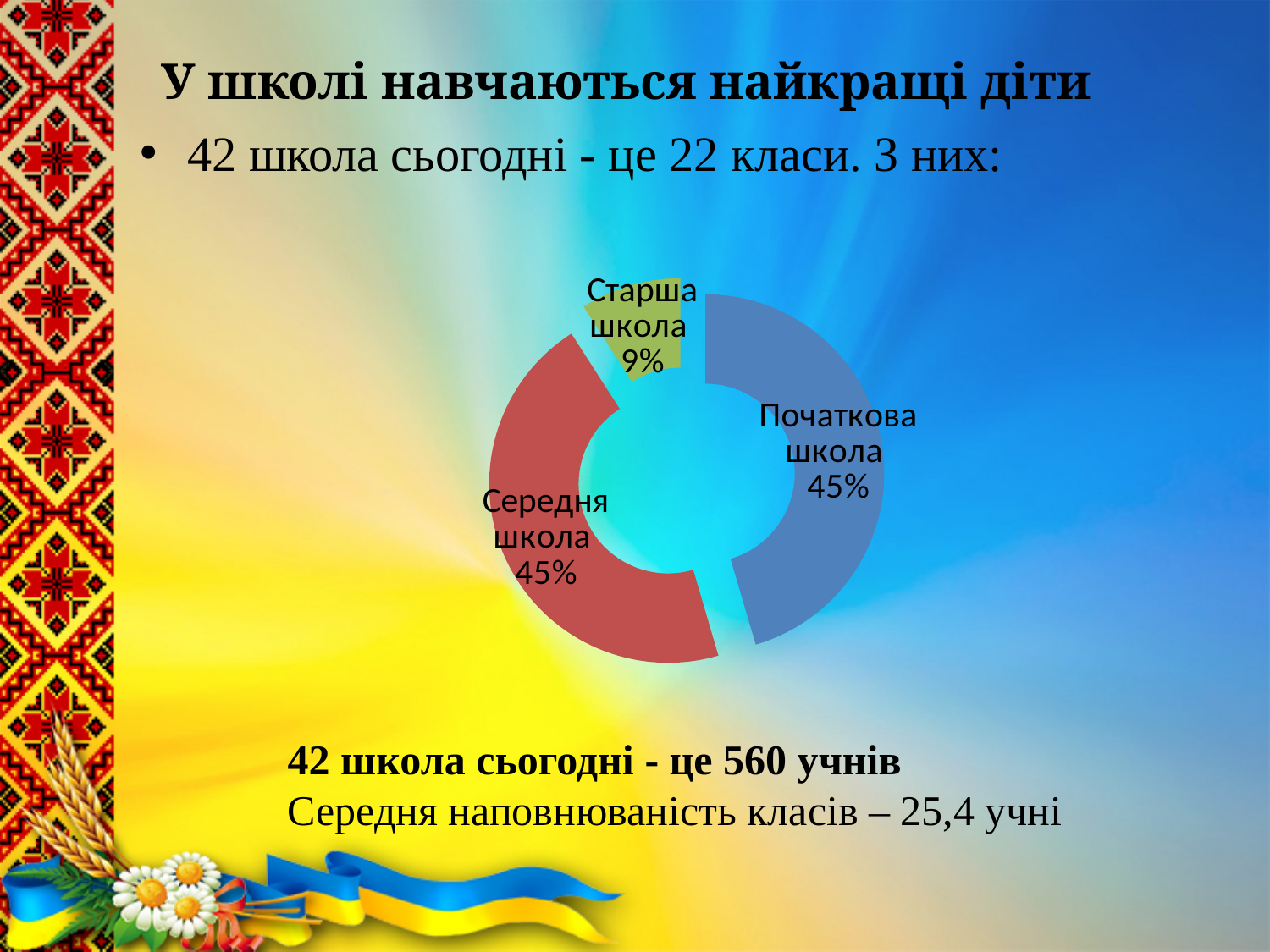
Which category has the smallest share of the chart? Старша школа By how many percentage points does the share for Середня школа exceed the share for Старша школа? 36 percentage points What colour is the Початкова школа segment of the chart? Blue How many categories does the chart show? 3 What share of the chart is labelled Середня школа? 45% What share of the chart is labelled Старша школа? 9% Which is larger, the share for Початкова школа or the share for Старша школа? Початкова школа What colour is the Старша школа segment of the chart? Green Which is larger, the share for Середня школа or the share for Старша школа? Середня школа What share of the chart is labelled Початкова школа? 45% By how many percentage points does the share for Початкова школа exceed the share for Старша школа? 36 percentage points What kind of chart is shown on the slide? Doughnut (pie) chart